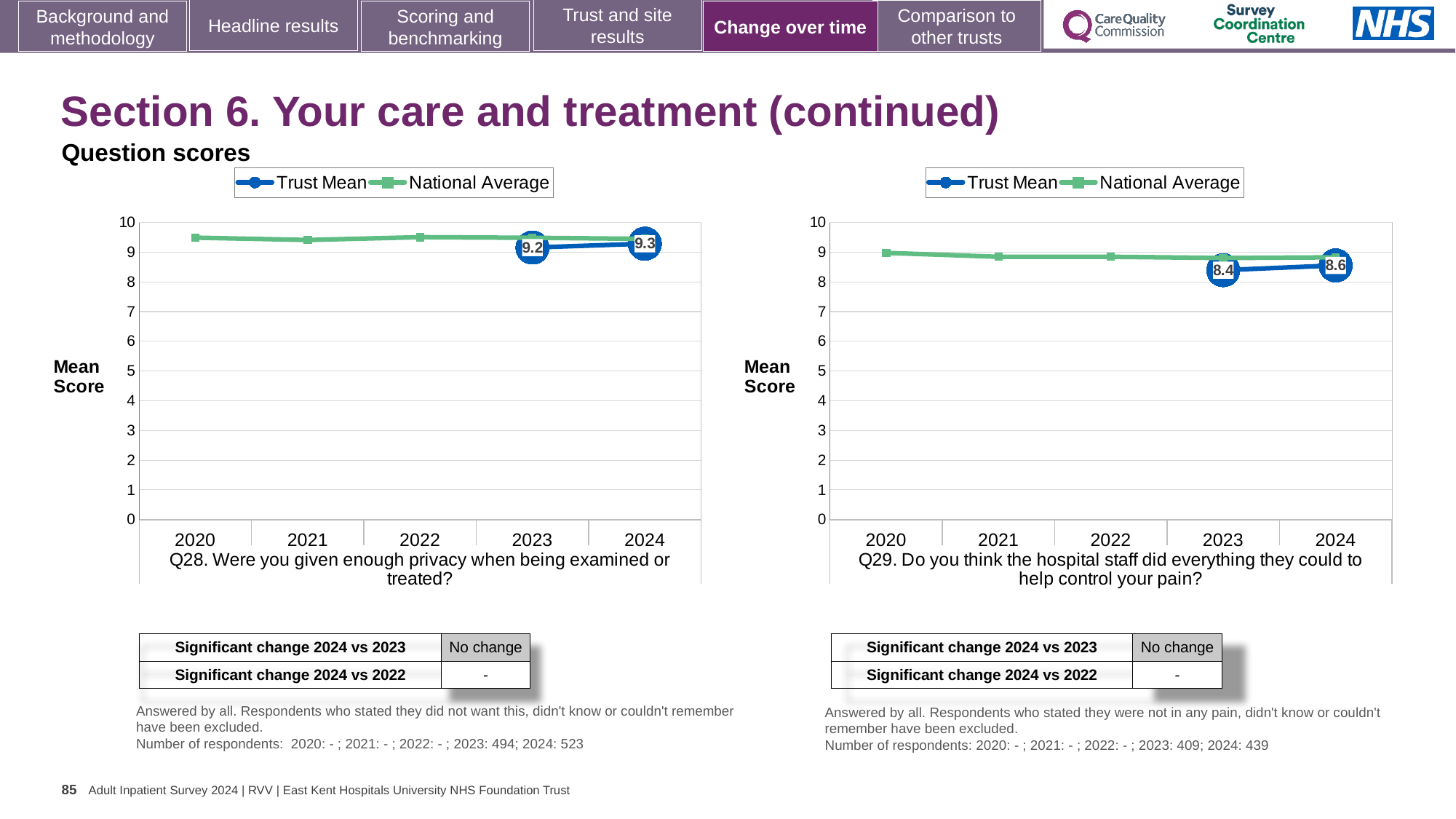
In the Q28 chart (left), what is the Trust Mean score for 2023? 9.2 How many years are shown on the x axis of the Q28 chart (left)? 5 In the Q29 chart (right), is the National Average value for 2021 greater or less than 8? greater In the Q29 chart (right), which is higher in 2023: the Trust Mean or the National Average? National Average In the Q29 chart (right), what is the Trust Mean score for 2023? 8.4 In the Q28 chart (left), what is the Trust Mean score for 2024? 9.3 How many series does the legend of the Q29 chart (right) list? 2 In the Q29 chart (right), what is the Trust Mean score for 2024? 8.6 What type of chart is used for Q28 (left)? Line chart In the Q28 chart (left), is the National Average value for 2020 greater or less than 9? greater In the Q28 chart (left), by how much did the Trust Mean change from 2023 to 2024? 0.1 In the Q29 chart (right), by how much did the Trust Mean change from 2023 to 2024? 0.2